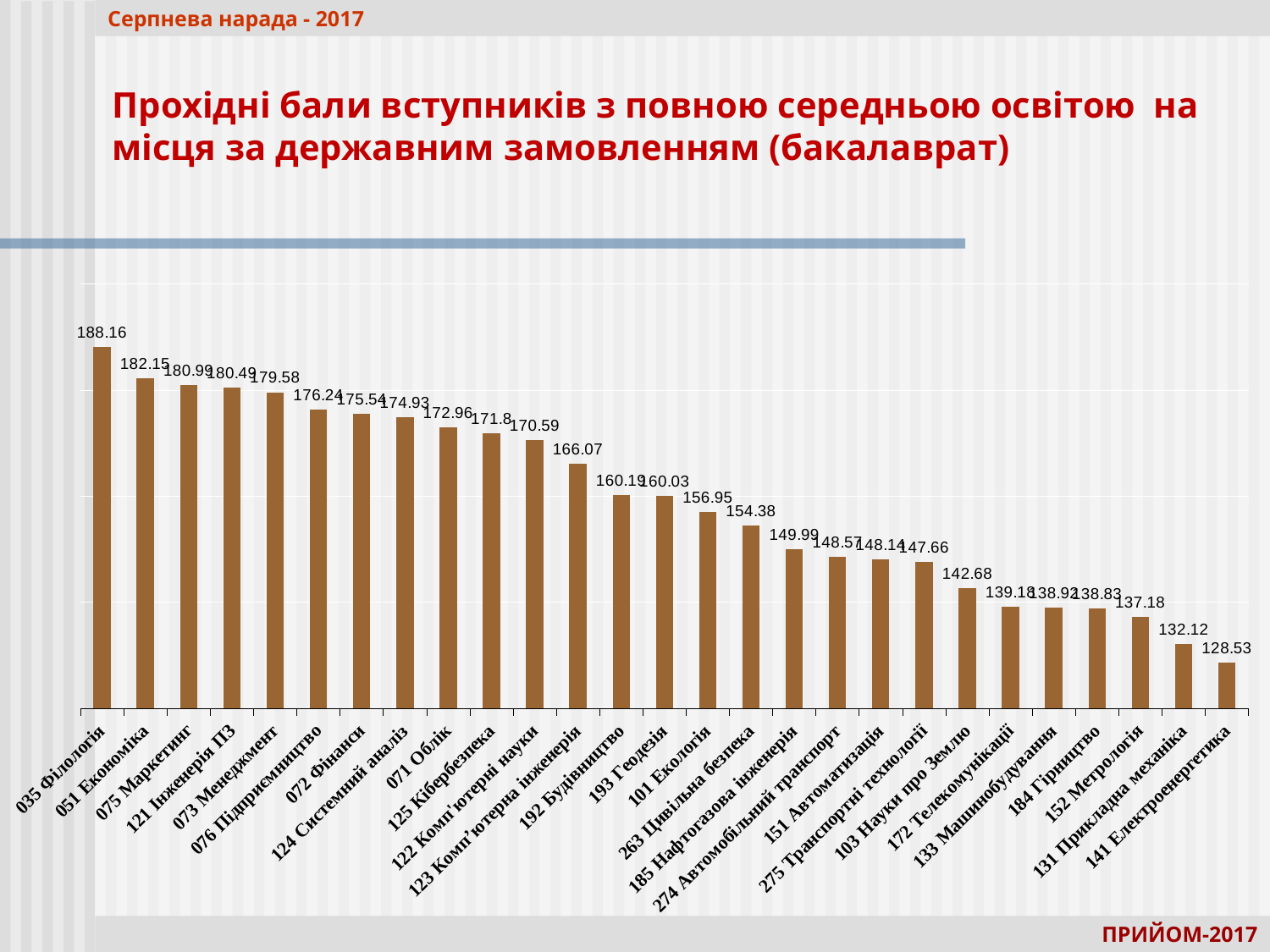
What is the value for 141 Електроенергетика? 128.53 What is the value for 035 Філологія? 188.16 What is the value for 123 Комп'ютерна інженерія? 166.07 Which category has the lowest value? 141 Електроенергетика What is the value for 103 Науки про Землю? 142.68 What kind of chart is shown on the slide? Bar chart What is the difference between the values for 035 Філологія and 141 Електроенергетика? 59.63 Which category has the highest value? 035 Філологія Which is larger, the value for 072 Фінанси or the value for 192 Будівництво? 072 Фінанси How many categories are shown in the chart? 27 What is the difference between the values for 051 Економіка and 101 Екологія? 25.2 Do the values rise or fall from left to right along the x axis? Fall